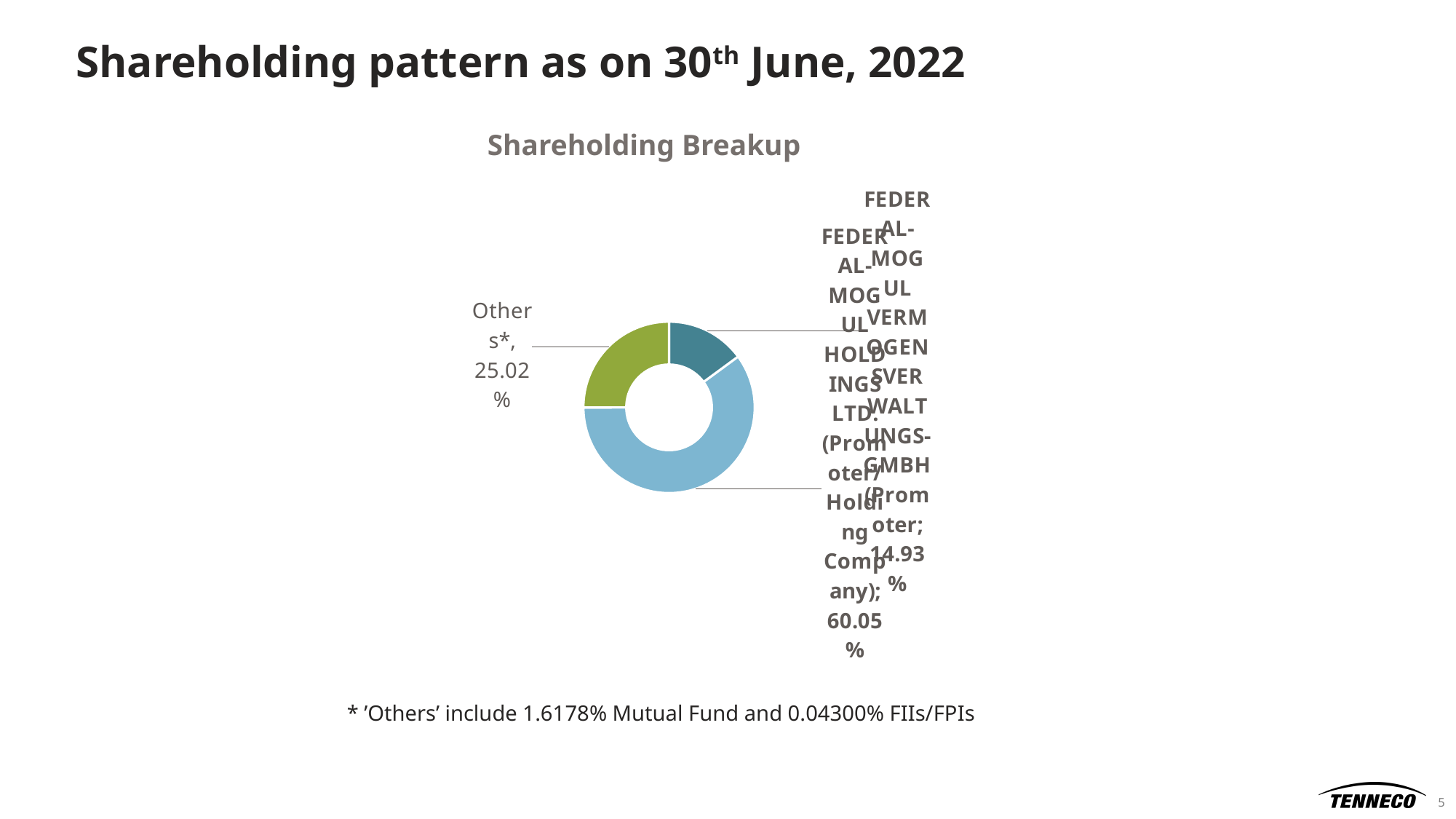
What share of shareholding is held by FEDERAL-MOGUL VERMOGENSVERWALTUNGS-GMBH (Promoter)? 14.93% Which is larger: the share of Others* or the share of FEDERAL-MOGUL VERMOGENSVERWALTUNGS-GMBH (Promoter)? Others* How many slices does the Shareholding Breakup chart have? 3 What is the difference between the share of Others* and the share of FEDERAL-MOGUL VERMOGENSVERWALTUNGS-GMBH (Promoter)? 10.09% Which shareholder category has the smallest share in the chart? FEDERAL-MOGUL VERMOGENSVERWALTUNGS-GMBH (Promoter) Which shareholder category has the largest share in the chart? FEDERAL-MOGUL HOLDINGS LTD. (Promoter/Holding Company) What colour is the slice for Others* in the chart? Green What is the difference between the share of FEDERAL-MOGUL HOLDINGS LTD. and the share of Others*? 35.03% What is the title of the chart on the slide? Shareholding Breakup What kind of chart is shown on the slide? Donut (pie) chart What share of shareholding is held by FEDERAL-MOGUL HOLDINGS LTD. (Promoter/Holding Company)? 60.05% What share of shareholding is held by Others*? 25.02%